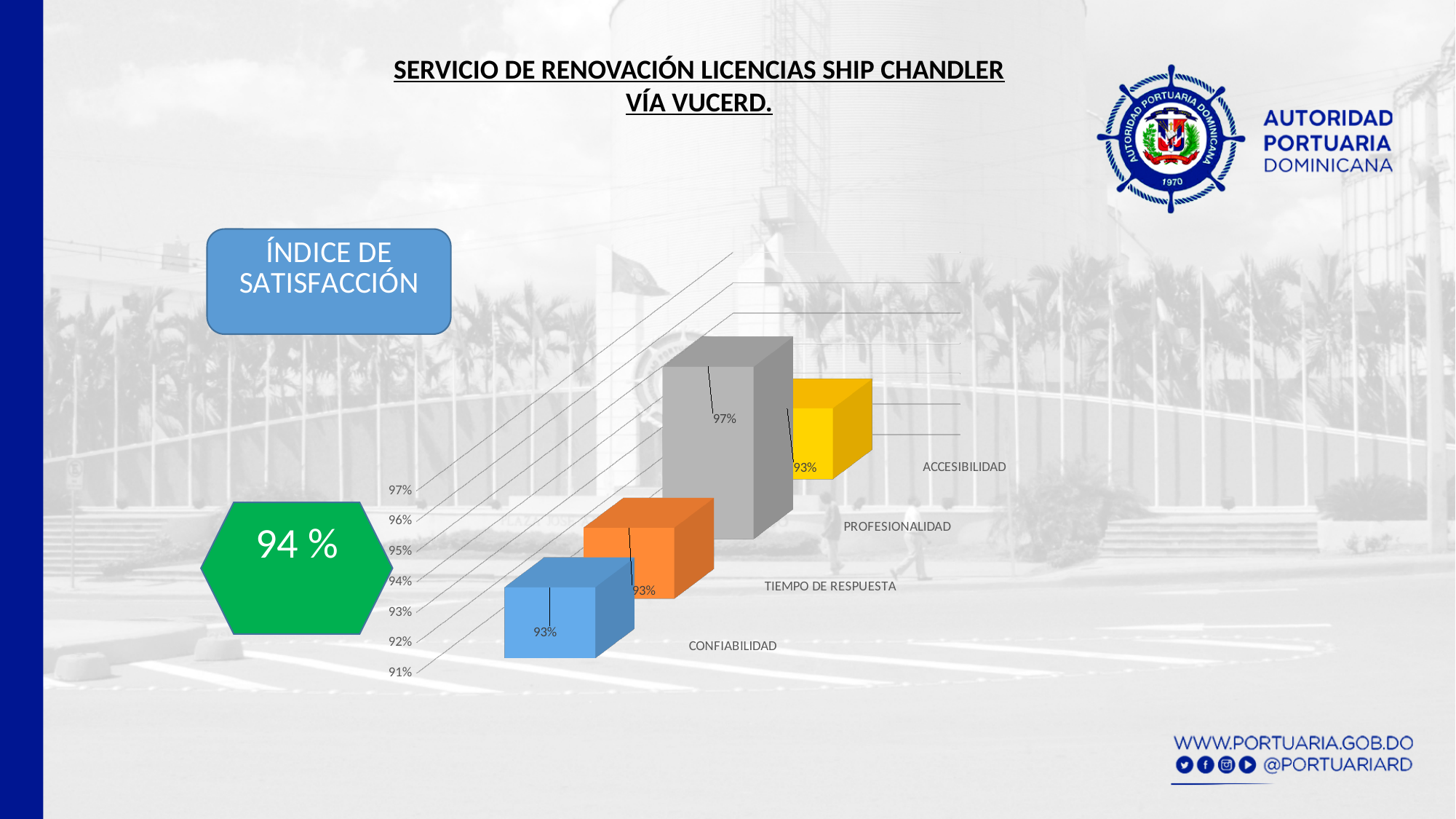
What is the value for TIEMPO DE RESPUESTA? 93% Is the value for PROFESIONALIDAD greater or less than 95%? greater What is the lowest value shown on the chart's vertical axis? 91% What is the value for PROFESIONALIDAD? 97% What is the difference between the values for PROFESIONALIDAD and ACCESIBILIDAD? 4% How many categories are shown in the chart? 4 Which category has the highest value? PROFESIONALIDAD What overall satisfaction index is shown in the green hexagon on the slide? 94 % What kind of chart is shown on the slide? bar chart Which is larger, the value for PROFESIONALIDAD or the value for CONFIABILIDAD? PROFESIONALIDAD What is the value for ACCESIBILIDAD? 93% What is the value for CONFIABILIDAD? 93%